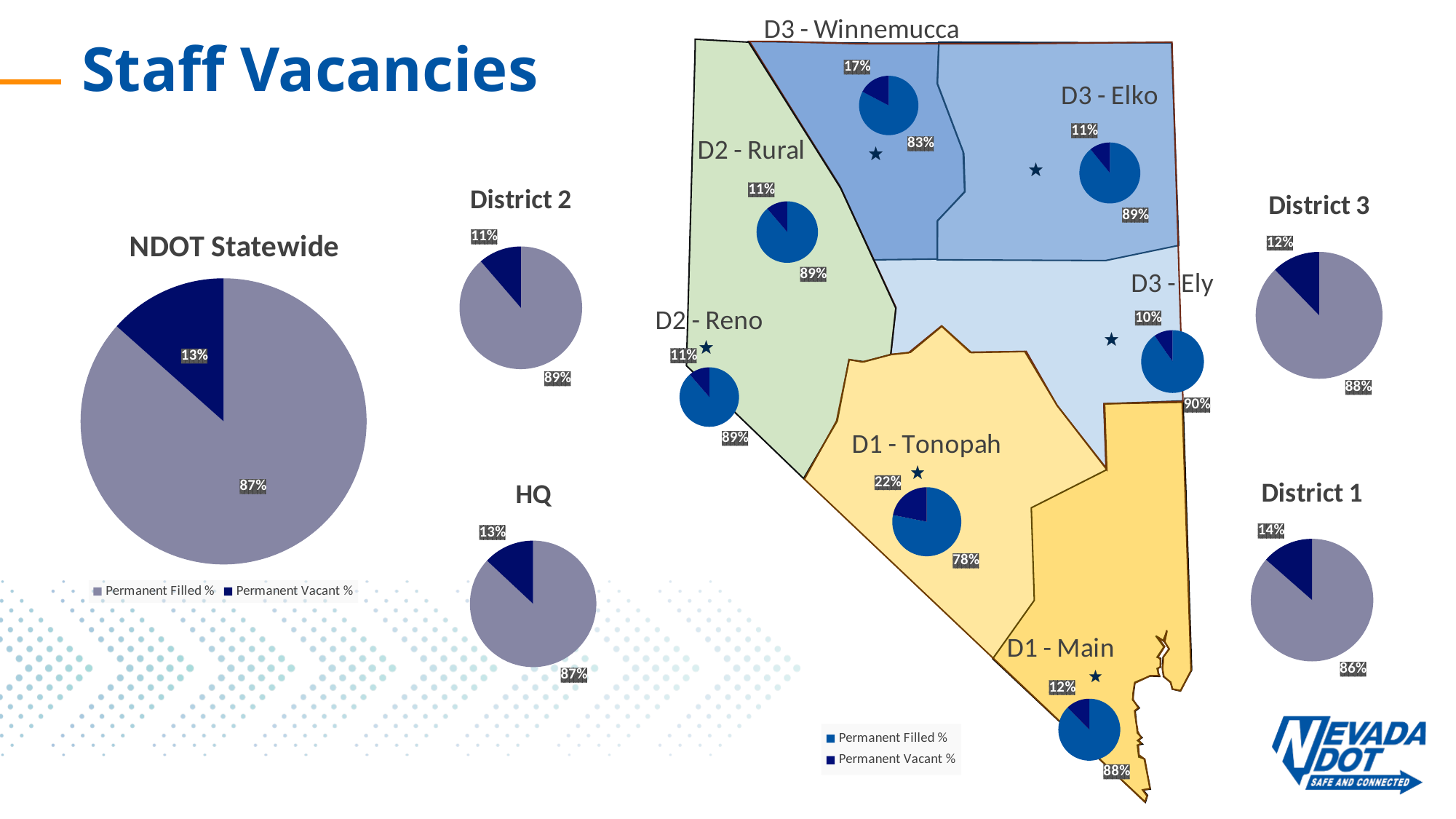
Which has a larger Permanent Vacant %, the HQ pie chart or the District 3 pie chart? HQ In the District 1 pie chart, what is the Permanent Filled %? 86% Which of the map pie charts (D1 - Tonopah, D1 - Main, D2 - Reno, D2 - Rural, D3 - Winnemucca, D3 - Elko, D3 - Ely) shows the lowest Permanent Vacant %? D3 - Ely What is the difference between the Permanent Vacant % in the District 1 pie chart and the District 2 pie chart? 3% In the District 2 pie chart, what is the Permanent Vacant %? 11% In the D3 - Ely pie chart on the map, what is the Permanent Filled %? 90% In the NDOT Statewide pie chart, what is the Permanent Filled %? 87% In the D3 - Winnemucca pie chart on the map, what is the Permanent Vacant %? 17% What type of chart is used for NDOT Statewide? Pie chart In the D1 - Tonopah pie chart on the map, what is the Permanent Vacant %? 22% Which of the map pie charts (D1 - Tonopah, D1 - Main, D2 - Reno, D2 - Rural, D3 - Winnemucca, D3 - Elko, D3 - Ely) shows the highest Permanent Vacant %? D1 - Tonopah In the NDOT Statewide pie chart, what is the Permanent Vacant %? 13%